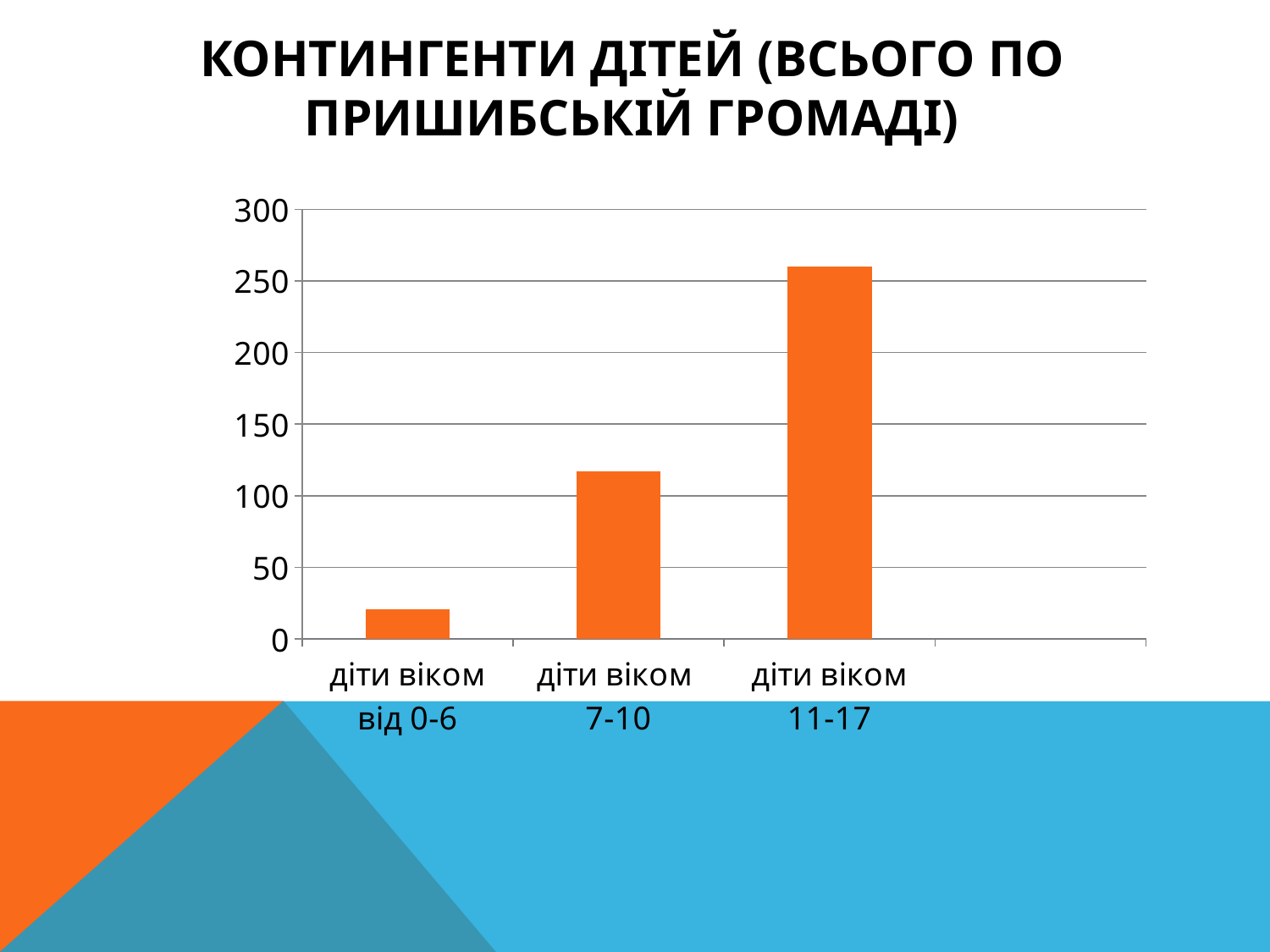
Which category has the highest value? діти віком 11-17 Which is larger, the value for діти віком 7-10 or the value for діти віком 11-17? діти віком 11-17 What kind of chart is shown on the slide? bar chart Is the value for діти віком від 0-6 greater or less than 50? less Is the value for діти віком 7-10 greater or less than 100? greater Is the value for діти віком 11-17 greater or less than 250? greater How many categories (bars) does the chart show? 3 What colour are the bars in the chart? orange Which category has the lowest value? діти віком від 0-6 Do the values rise or fall from left to right across the categories? rise What is the title of the chart on the slide? КОНТИНГЕНТИ ДІТЕЙ (ВСЬОГО ПО ПРИШИБСЬКІЙ ГРОМАДІ)